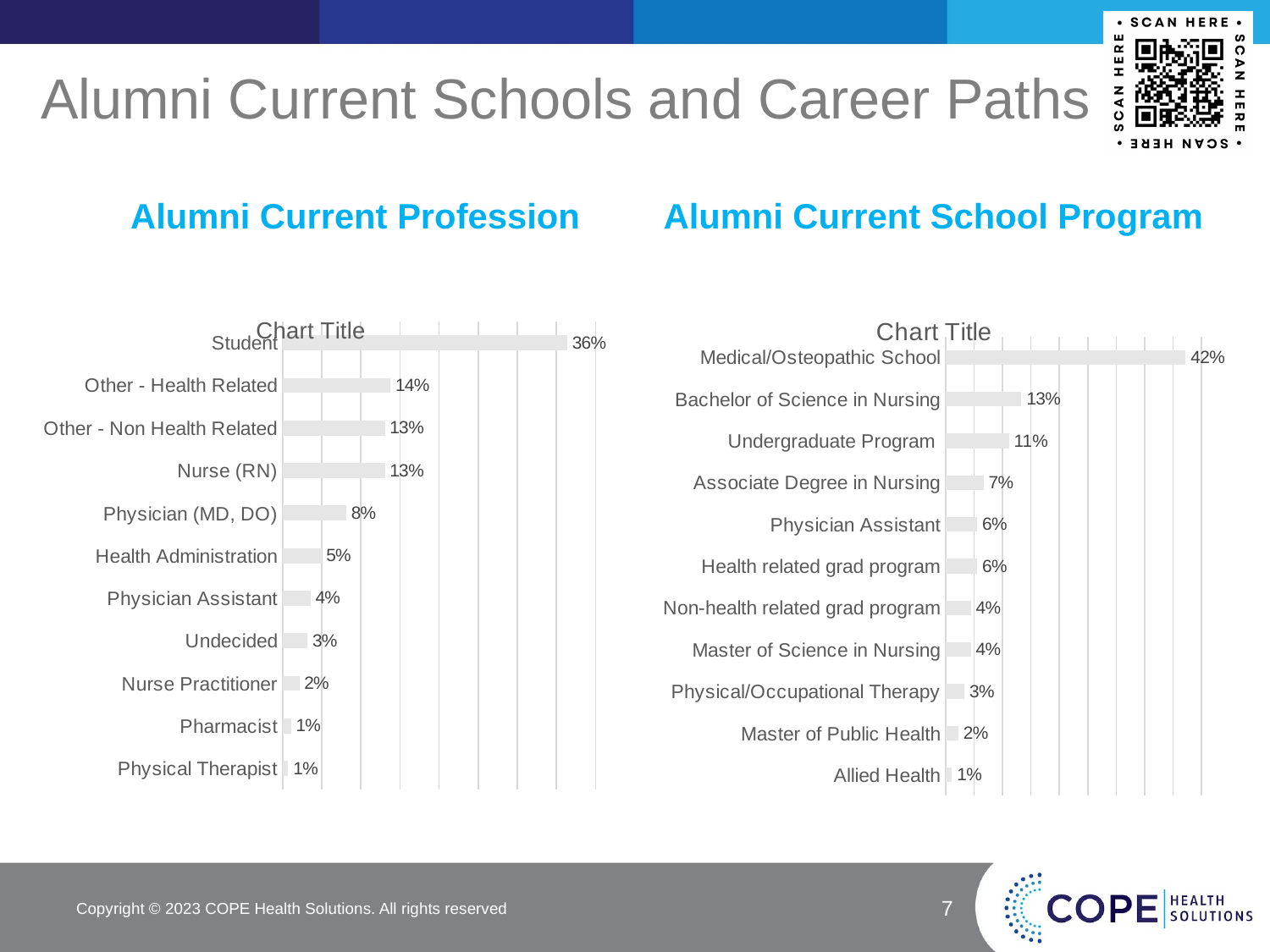
How many categories are shown in the Alumni Current Profession chart? 11 In the Alumni Current School Program chart, which is larger: Master of Public Health or Physical/Occupational Therapy? Physical/Occupational Therapy In the Alumni Current School Program chart, which category has the lowest value? Allied Health In the Alumni Current Profession chart, what is the value for Physician (MD, DO)? 8% In the Alumni Current School Program chart, what is the value for Undergraduate Program? 11% In the Alumni Current Profession chart, what percentage of alumni are Students? 36% In the Alumni Current Profession chart, what is the difference between Student and Other - Health Related? 22% In the Alumni Current Profession chart, which is larger: Health Administration or Physician Assistant? Health Administration In the Alumni Current School Program chart, what is the value for Medical/Osteopathic School? 42% In the Alumni Current School Program chart, what is the difference between Bachelor of Science in Nursing and Associate Degree in Nursing? 6% What type of chart is the Alumni Current School Program chart? Bar chart In the Alumni Current Profession chart, which category has the highest value? Student